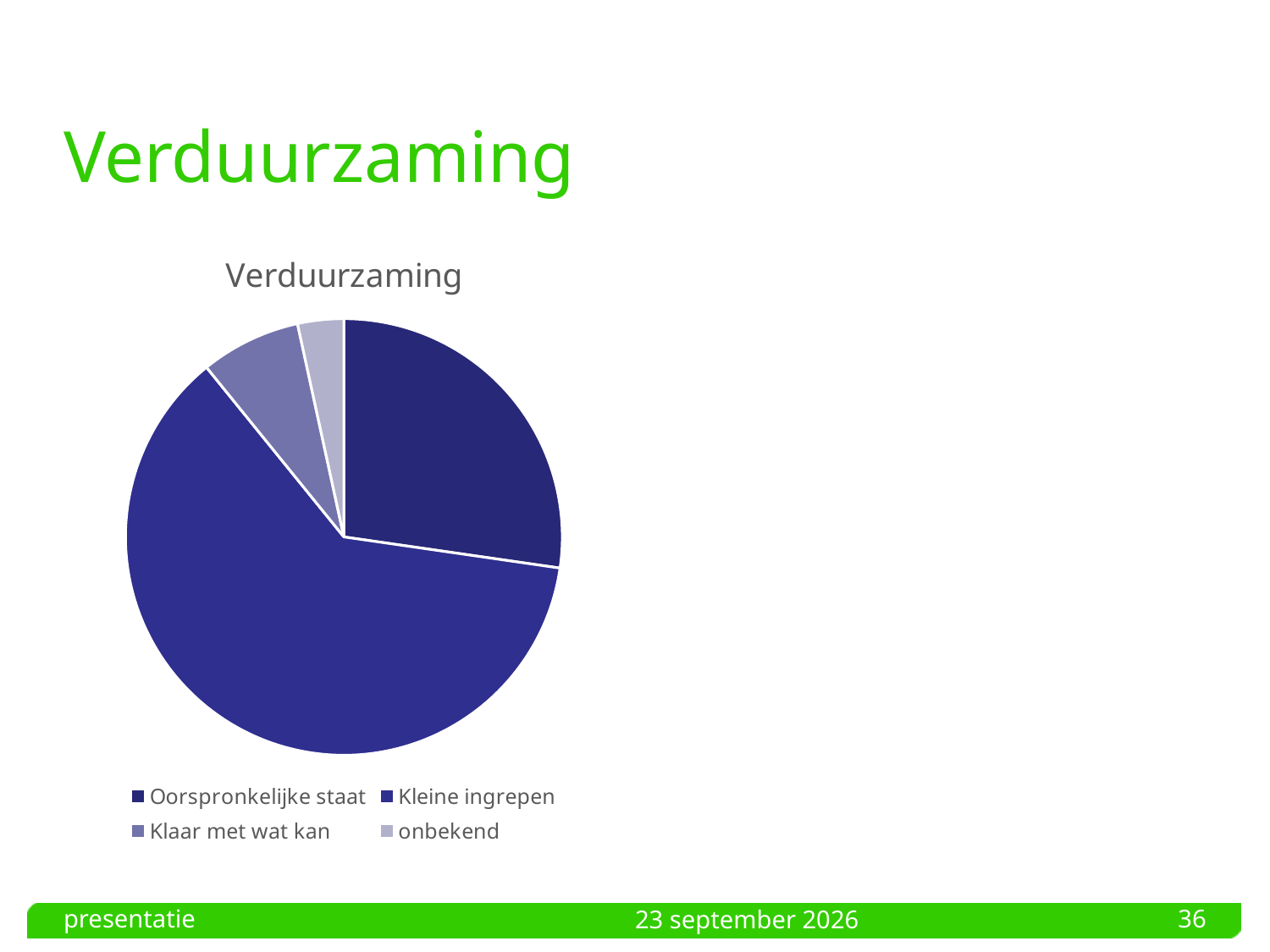
How many slices does the pie chart have? 4 What kind of chart is shown on the slide? pie chart What is the title of the chart? Verduurzaming Which category has the largest slice of the pie? Kleine ingrepen Which slice is larger: Kleine ingrepen or Oorspronkelijke staat? Kleine ingrepen Which slice is larger: Klaar met wat kan or onbekend? Klaar met wat kan How many entries does the legend list? 4 Which category has the smallest slice of the pie? onbekend Which legend entry is shown in the lightest colour? onbekend Which slice is larger: Oorspronkelijke staat or Klaar met wat kan? Oorspronkelijke staat Which category is the second largest slice of the pie? Oorspronkelijke staat